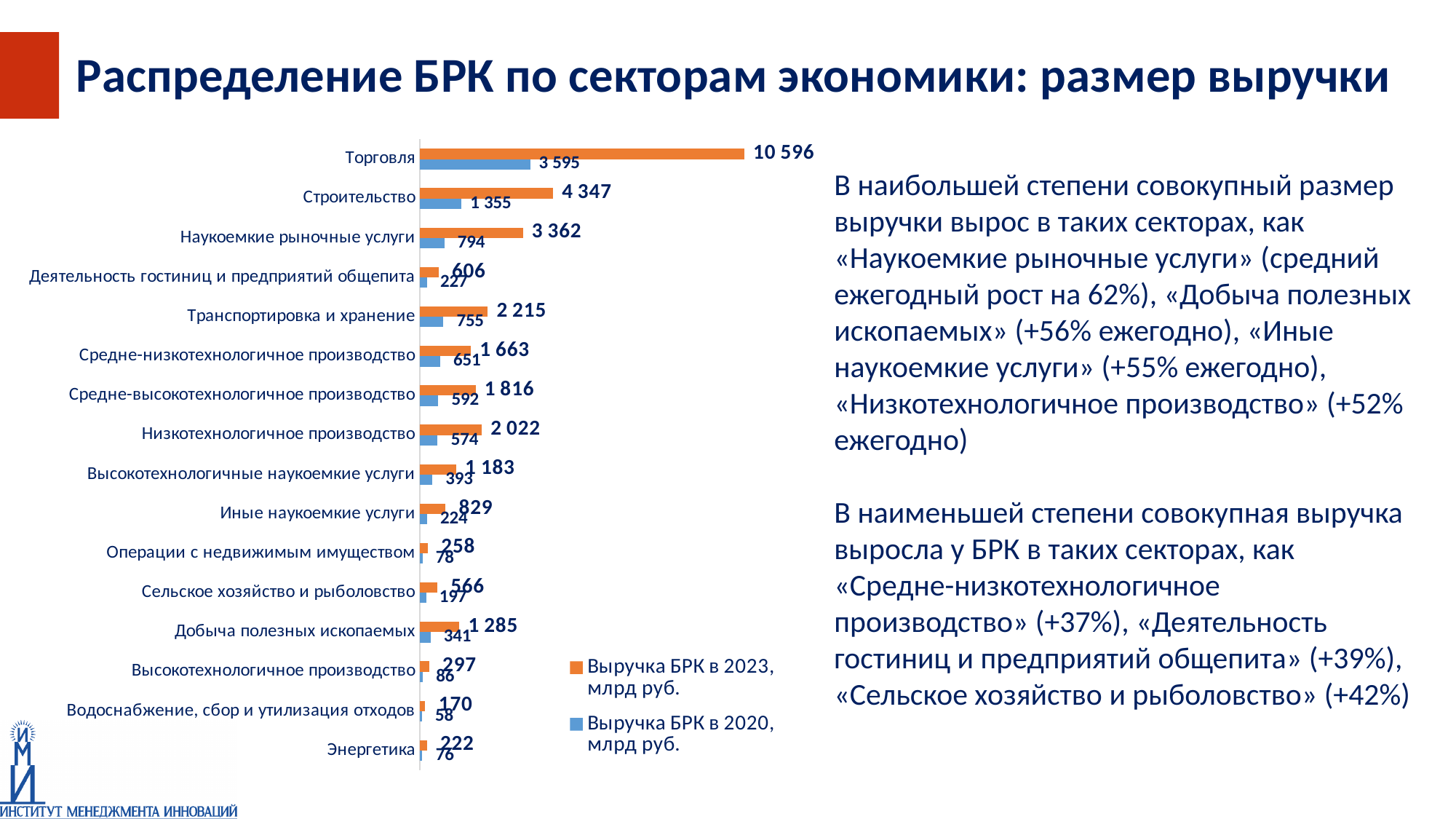
What is the value of 'Выручка БРК в 2023, млрд руб.' for Наукоемкие рыночные услуги? 3 362 What is the value of 'Выручка БРК в 2020, млрд руб.' for Транспортировка и хранение? 755 Which colour represents the series 'Выручка БРК в 2020, млрд руб.'? blue How many sectors (categories) are shown in the chart? 16 What is the value of 'Выручка БРК в 2020, млрд руб.' for Строительство? 1 355 What is the value of 'Выручка БРК в 2023, млрд руб.' for Торговля? 10 596 Which sector has the lowest value for 'Выручка БРК в 2023, млрд руб.'? Водоснабжение, сбор и утилизация отходов What type of chart is shown on the slide? bar chart How many series does the chart legend list? 2 Which sector has the larger 2023 revenue value: Низкотехнологичное производство or Средне-высокотехнологичное производство? Низкотехнологичное производство What is the difference between the 2023 and 2020 revenue values for Торговля? 7 001 Which sector has the highest value for 'Выручка БРК в 2023, млрд руб.'? Торговля